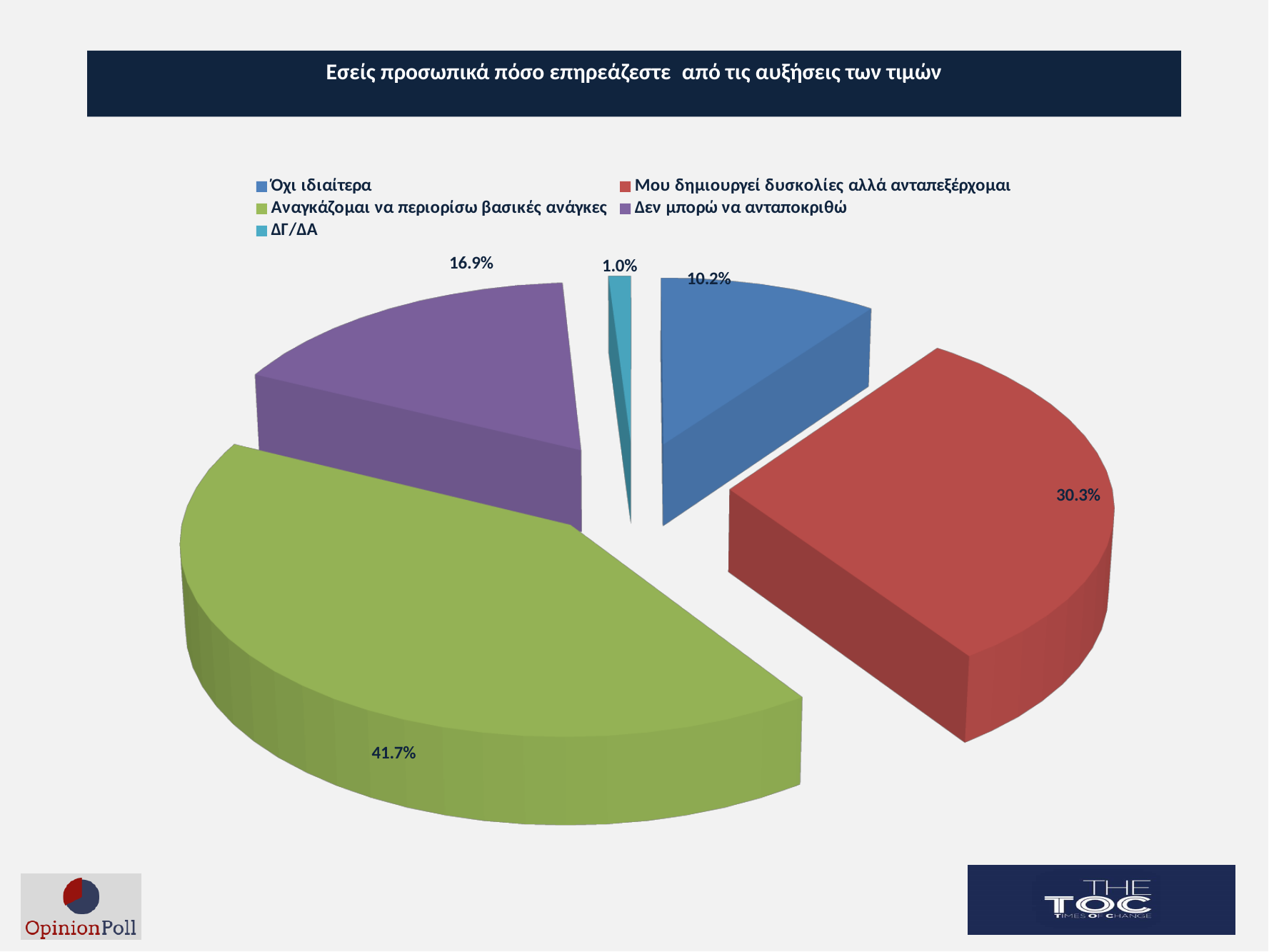
What percentage of respondents answered "ΔΓ/ΔΑ"? 1.0% Which response has the smallest share of the pie? ΔΓ/ΔΑ What colour is the slice for "Μου δημιουργεί δυσκολίες αλλά ανταπεξέρχομαι"? Red What is the difference in percentage points between "Αναγκάζομαι να περιορίσω βασικές ανάγκες" and "Μου δημιουργεί δυσκολίες αλλά ανταπεξέρχομαι"? 11.4 What percentage of respondents answered "Μου δημιουργεί δυσκολίες αλλά ανταπεξέρχομαι"? 30.3% How many categories are shown in the pie chart? 5 What type of chart is shown on the slide? Pie chart What percentage of respondents answered "Αναγκάζομαι να περιορίσω βασικές ανάγκες"? 41.7% Which response has the largest share of the pie? Αναγκάζομαι να περιορίσω βασικές ανάγκες What percentage of respondents answered "Δεν μπορώ να ανταποκριθώ"? 16.9% What percentage of respondents answered "Όχι ιδιαίτερα"? 10.2% Which is larger: the share for "Δεν μπορώ να ανταποκριθώ" or the share for "Όχι ιδιαίτερα"? Δεν μπορώ να ανταποκριθώ